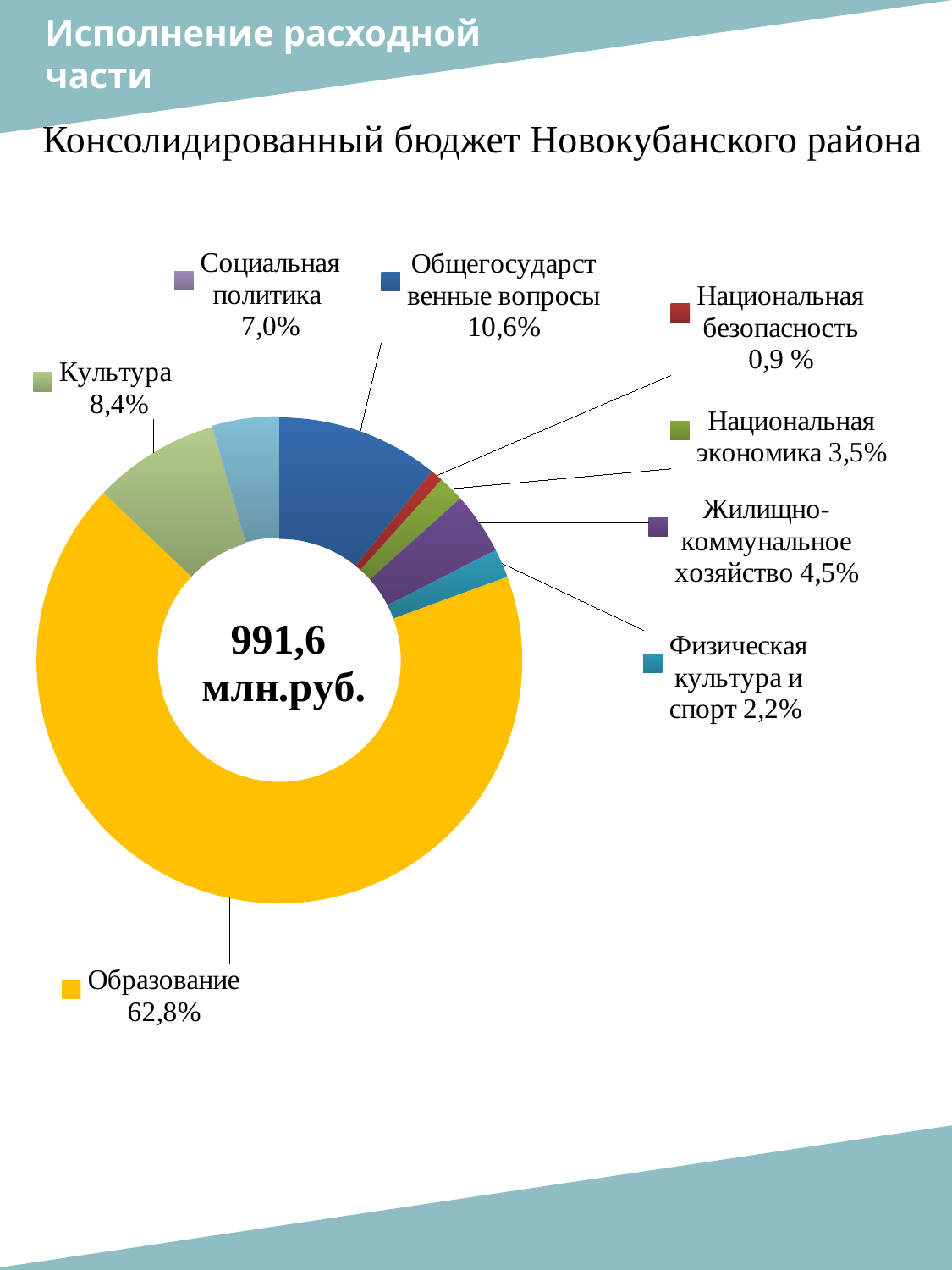
What percentage is shown for Культура? 8,4% Which is larger, the share for Национальная экономика or the share for Физическая культура и спорт? Национальная экономика What is the difference between the shares of Общегосударственные вопросы and Социальная политика? 3,6% Which category has the smallest share of the chart? Национальная безопасность How many categories are shown in the chart? 8 What is the difference between the shares of Культура and Социальная политика? 1,4% What is the value shown for Общегосударственные вопросы? 10,6% What total amount is printed in the centre of the chart? 991,6 млн.руб. What is the value for Жилищно-коммунальное хозяйство? 4,5% What share of the chart does Образование account for? 62,8% Which category has the largest share of the chart? Образование What kind of chart is shown on the slide? Doughnut (pie) chart